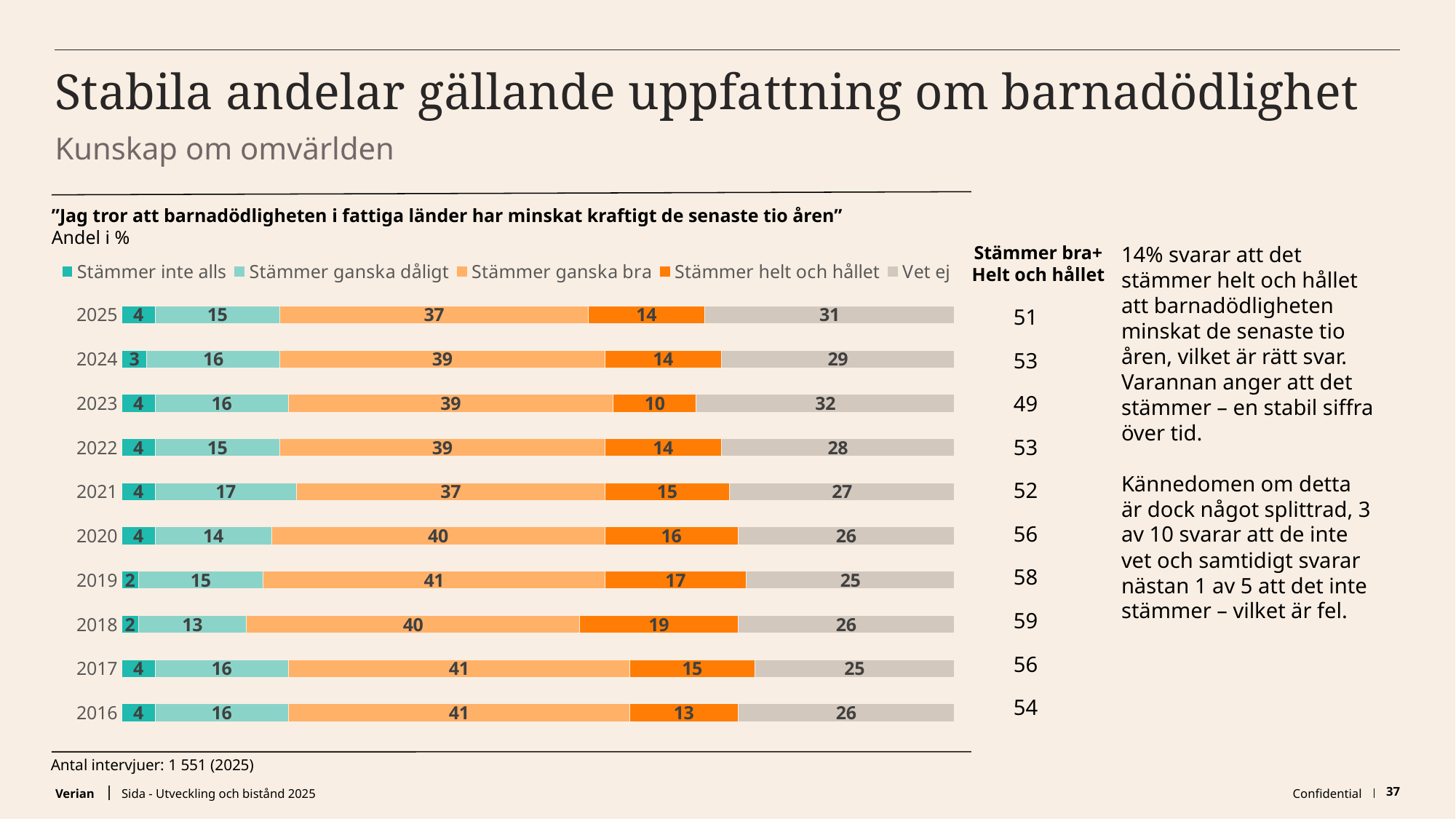
What is the difference between the "Vet ej" values for 2025 and 2024? 2 What is the value for "Stämmer helt och hållet" in 2025? 14 How many years are shown in the chart? 10 In which year is the value for "Stämmer helt och hållet" highest? 2018 Which is larger: the "Stämmer ganska dåligt" value in 2021 or in 2018? 2021 How many series does the legend list? 5 What kind of chart is shown on the slide? Stacked bar chart Which series is listed first in the legend? Stämmer inte alls What is the value for "Stämmer ganska bra" in 2020? 40 What is the value for "Vet ej" in 2023? 32 What is the total of the stacked bar for 2022? 100 In which year is the value for "Stämmer helt och hållet" lowest? 2023